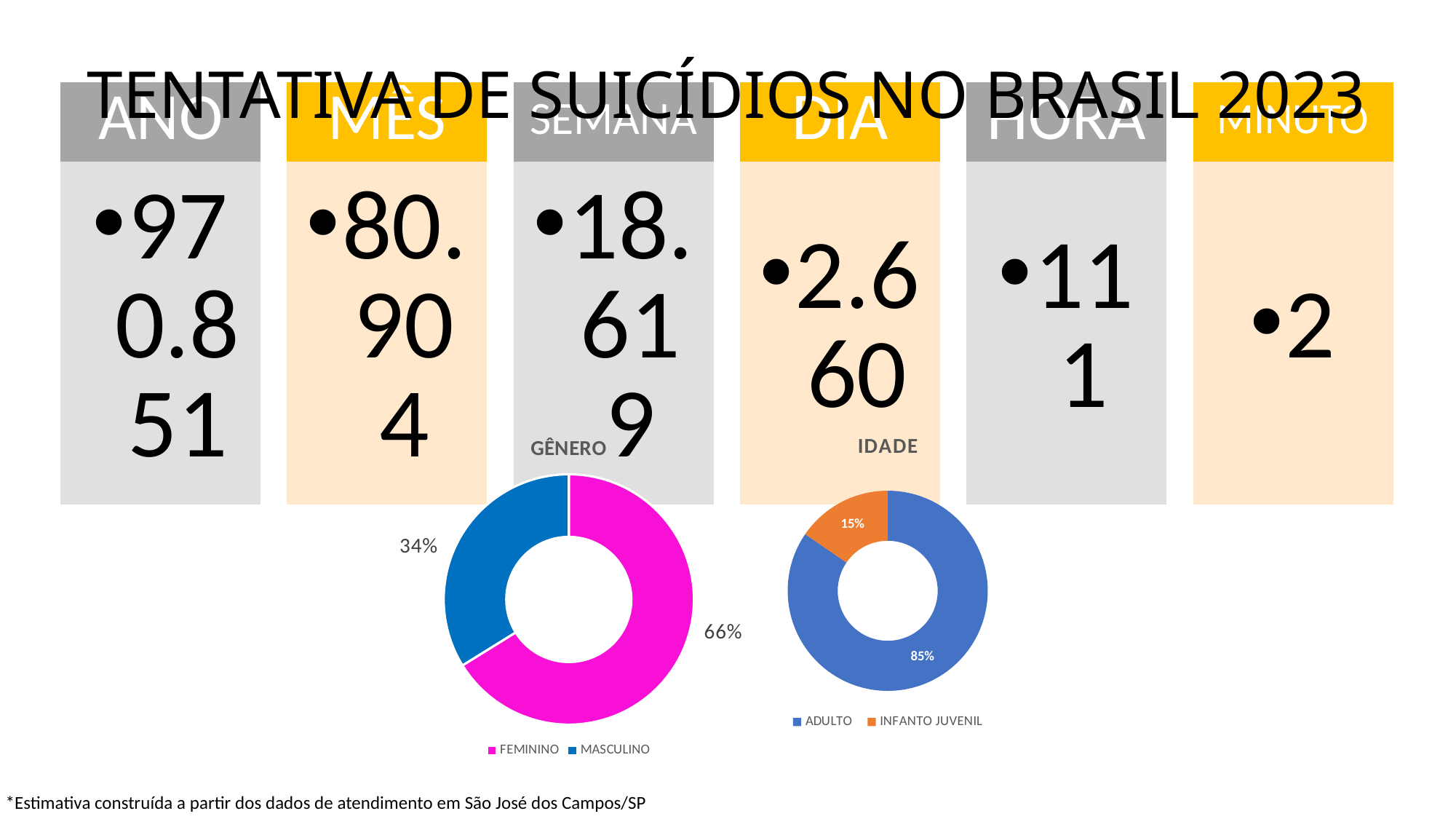
In the GÊNERO chart, which category has the largest share? FEMININO In the IDADE chart, what is the difference in percentage points between ADULTO and INFANTO JUVENIL? 70 In the GÊNERO chart, what percentage is shown for MASCULINO? 34% How many categories does the legend of the IDADE chart list? 2 In the IDADE chart, which is larger, ADULTO or INFANTO JUVENIL? ADULTO What kind of chart is the GÊNERO chart? Donut (pie) chart In the IDADE chart, which category has the smallest share? INFANTO JUVENIL In the GÊNERO chart, what is the difference in percentage points between FEMININO and MASCULINO? 32 In the IDADE chart, what percentage is shown for ADULTO? 85% In the GÊNERO chart, what percentage is shown for FEMININO? 66% In the IDADE chart, what percentage is shown for INFANTO JUVENIL? 15% In the GÊNERO chart, what colour is the FEMININO slice? Magenta (pink)